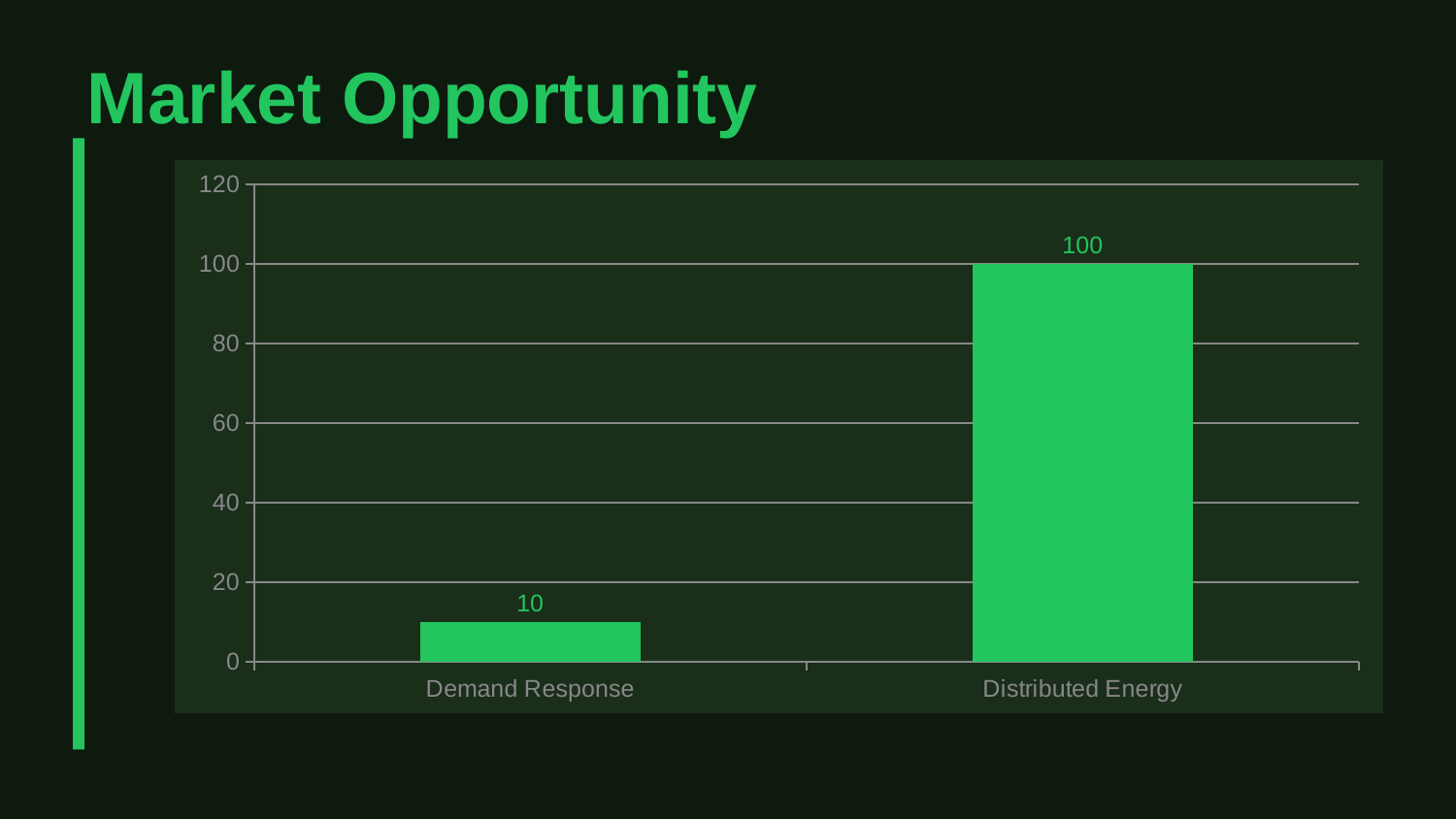
What is the highest value shown on the y axis? 120 What is the title of the slide containing the chart? Market Opportunity Is the value for Distributed Energy greater or less than 80? greater Which category has the highest value? Distributed Energy Which is larger, the value for Demand Response or the value for Distributed Energy? Distributed Energy Is the value for Demand Response greater or less than 20? less What kind of chart is shown on the slide? bar chart What is the difference between the values for Distributed Energy and Demand Response? 90 Which category has the lowest value? Demand Response What is the value for Distributed Energy? 100 What is the value for Demand Response? 10 How many categories are shown on the x axis? 2